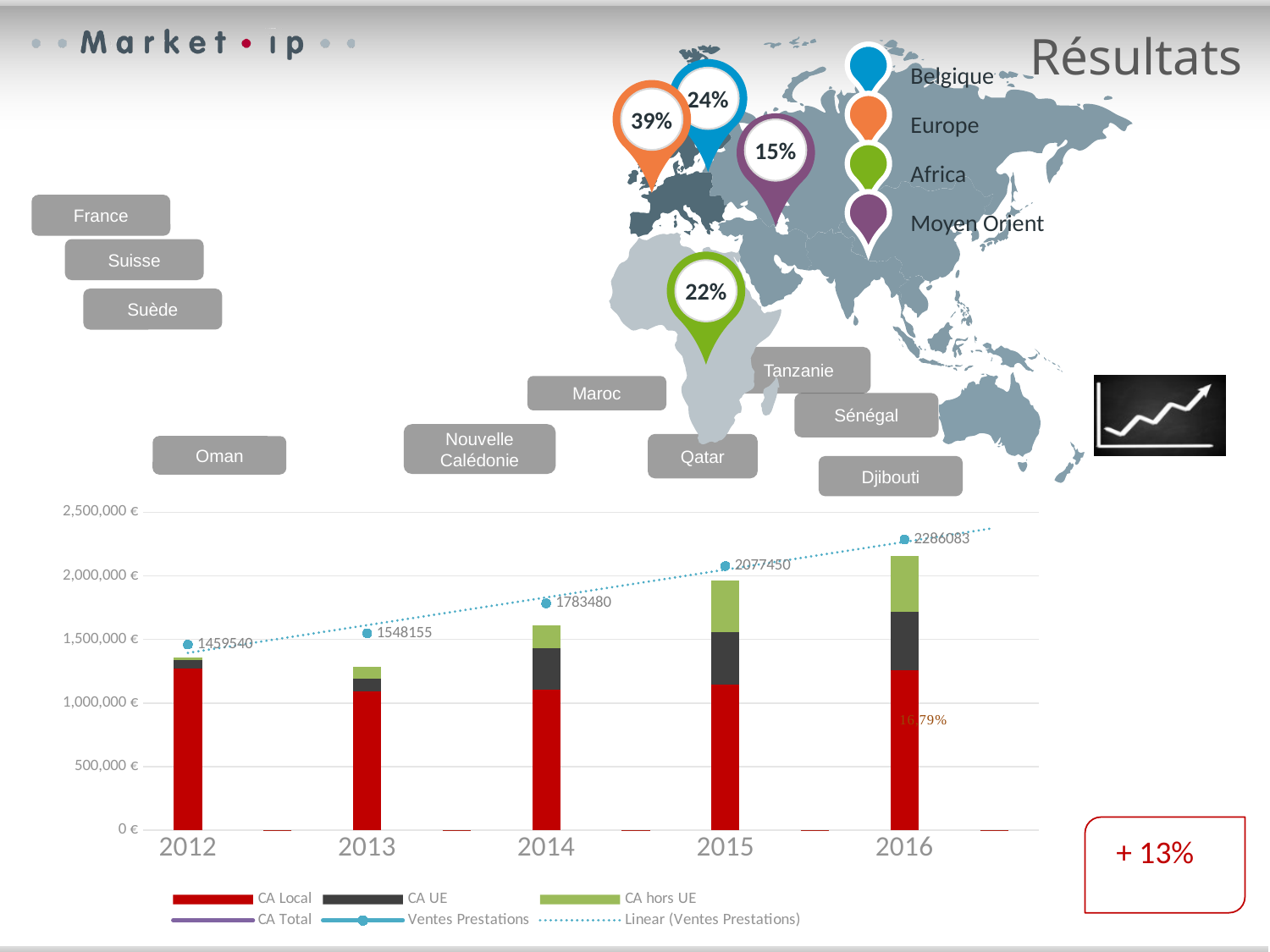
How many entries does the chart legend list? 6 Which year has the larger Ventes Prestations value, 2013 or 2015? 2015 Is the total height of the stacked bar for 2013 greater or less than 1,500,000 €? less Do the Ventes Prestations values rise or fall from 2012 to 2016? rise Is the CA Local value for 2012 greater or less than 1,000,000 €? greater In which year is the Ventes Prestations value lowest? 2012 What is the Ventes Prestations value labelled for 2014? 1783480 In which year is the Ventes Prestations value highest? 2016 What is the difference between the Ventes Prestations values for 2016 and 2012? 826543 What is the Ventes Prestations value labelled for 2016? 2286083 How many years are shown on the x axis of the chart? 5 What is the Ventes Prestations value labelled for 2012? 1459540